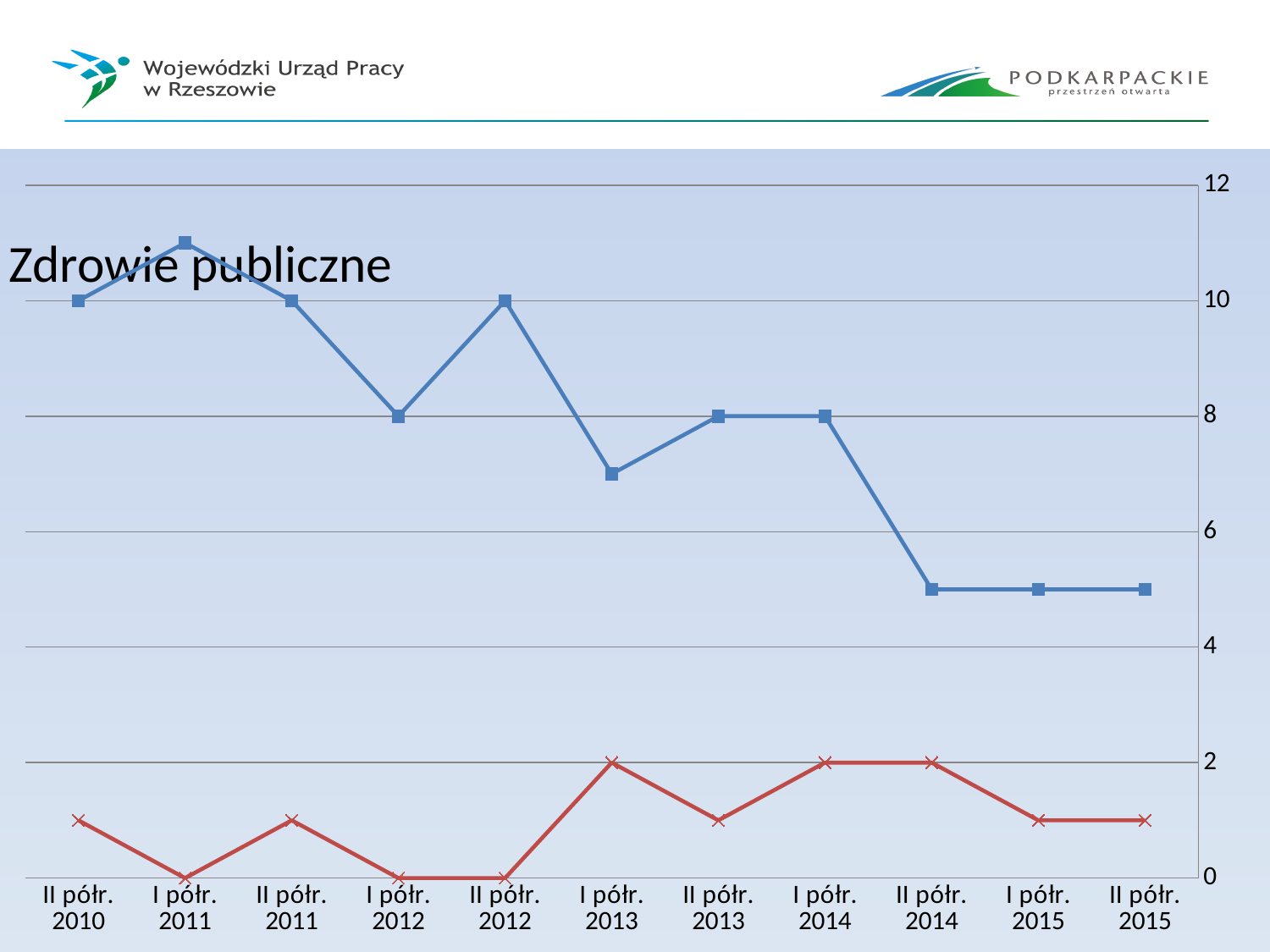
In which period does the blue line reach its highest value? I półr. 2011 What is the title of the chart? Zdrowie publiczne Is the value of the blue line for I półr. 2013 greater or less than 6? greater What is the value of the blue line for I półr. 2012? 8 What kind of chart is shown on the slide? line chart Does the blue line overall rise or fall from II półr. 2010 to II półr. 2015? fall How many periods are shown on the x axis of the chart? 11 What is the value of the red line for I półr. 2013? 2 What is the value of the blue line for II półr. 2010? 10 What is the value of the red line for I półr. 2011? 0 Is the value of the blue line for II półr. 2014 greater or less than 6? less What is the difference between the blue line's values for II półr. 2010 and I półr. 2012? 2